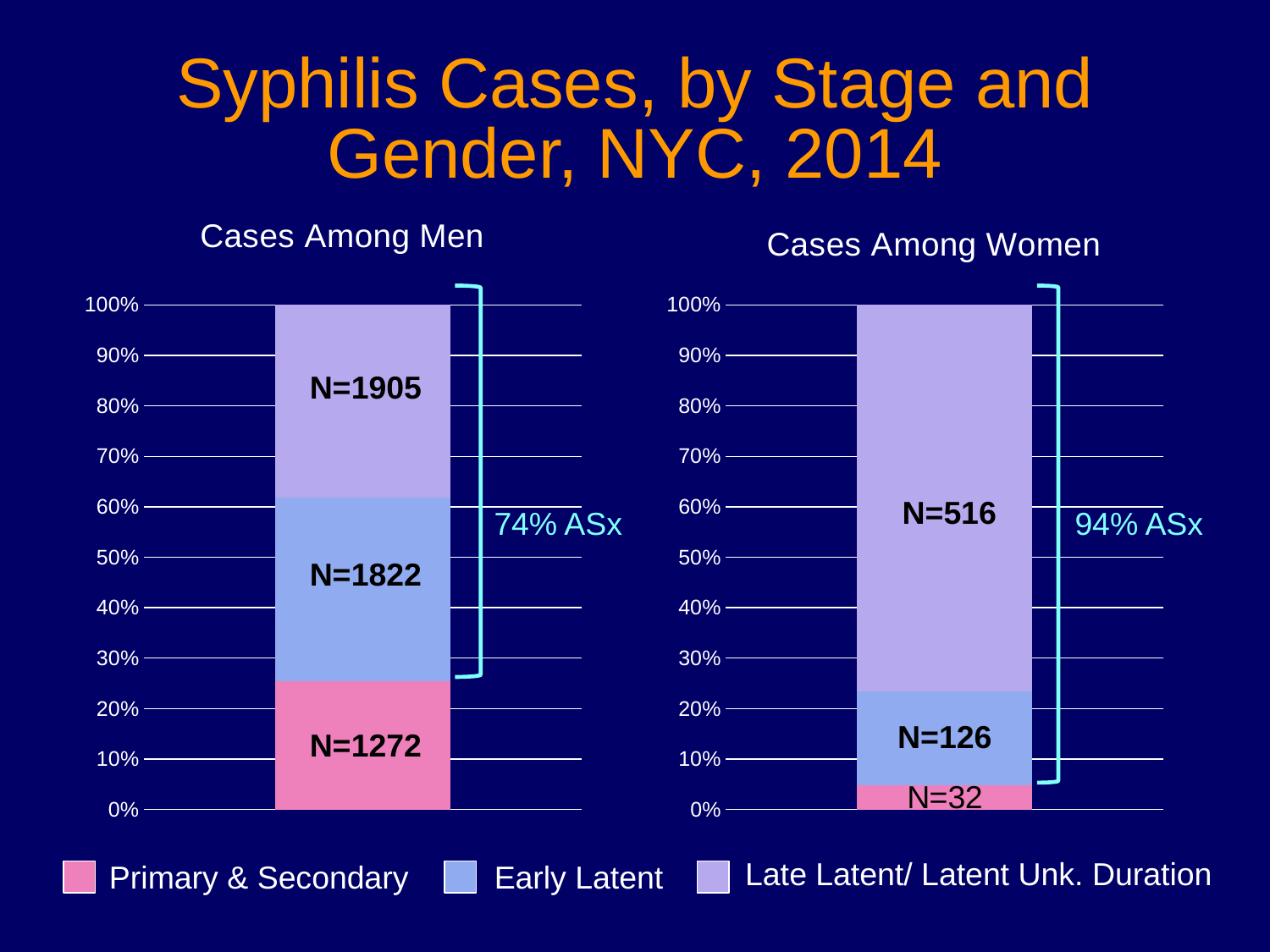
What is the total number of cases shown in the Cases Among Women bar? 674 How many series does the legend list? 3 In the Cases Among Men chart, is the Early Latent count larger or smaller than the Late Latent/ Latent Unk. Duration count? smaller What kind of chart is used for Cases Among Men? stacked bar chart In the Cases Among Men chart, what is the N value for the Late Latent/ Latent Unk. Duration segment? N=1905 In the Cases Among Women chart, which stage has the largest number of cases? Late Latent/ Latent Unk. Duration In the Cases Among Men chart, which stage has the smallest number of cases? Primary & Secondary In the Cases Among Men chart, is the Primary & Secondary share of the bar greater or less than 30%? less In the Cases Among Women chart, what is the difference between the Late Latent/ Latent Unk. Duration count and the Early Latent count? 390 What percentage ASx is annotated next to the Cases Among Women chart? 94% ASx In the Cases Among Women chart, what is the N value for the Primary & Secondary segment? N=32 In the Cases Among Men chart, what is the N value for the Early Latent segment? N=1822